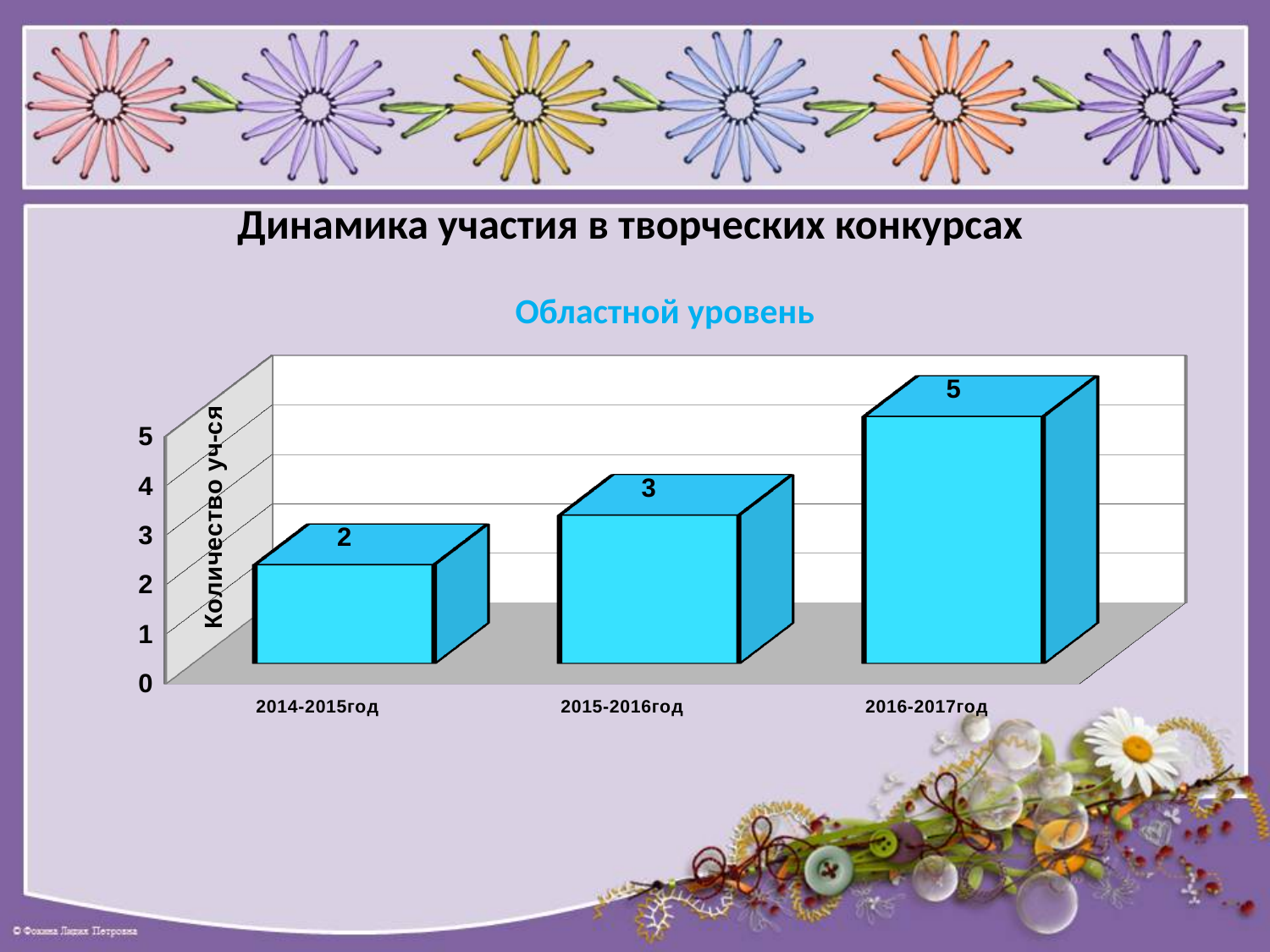
Do the values rise or fall from 2014-2015год to 2016-2017год? rise What is the title of the chart? Областной уровень Which year has the highest value? 2016-2017год Which year has the lowest value? 2014-2015год What is the value for 2015-2016год? 3 What is the difference between the values for 2016-2017год and 2014-2015год? 3 What is the value for 2014-2015год? 2 Which is larger, the value for 2015-2016год or 2016-2017год? 2016-2017год What is the value for 2016-2017год? 5 What is the difference between the values for 2015-2016год and 2014-2015год? 1 How many categories are shown on the x axis? 3 What kind of chart is shown? bar chart